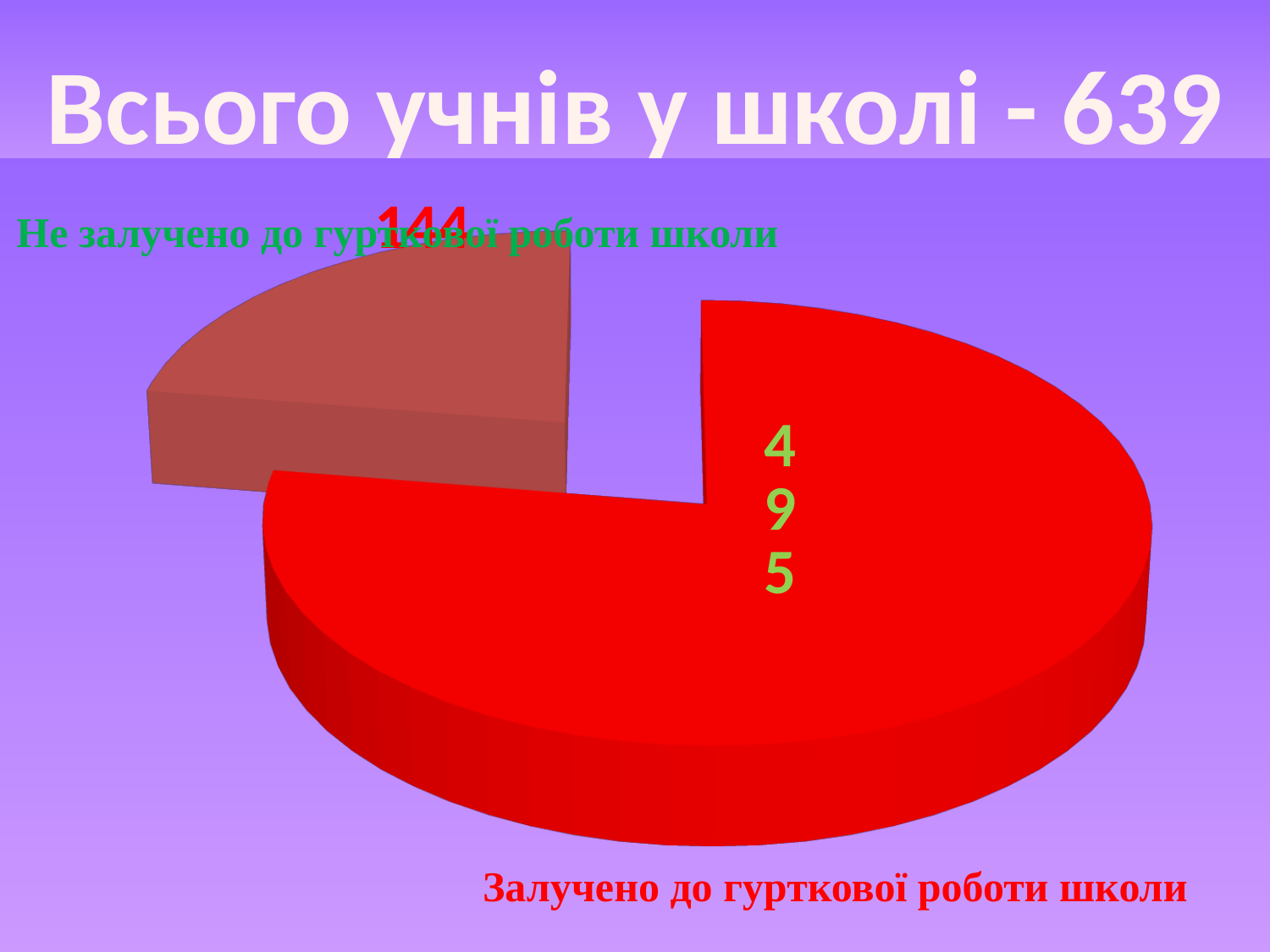
What is the value for "Не залучено до гурткової роботи школи"? 144 What is the total number of pupils represented by the two slices of the pie chart? 639 How many slices does the pie chart have? 2 What colour is the slice for "Залучено до гурткової роботи школи"? red Which slice of the pie chart is the smallest? Не залучено до гурткової роботи школи Which slice of the pie chart is the largest? Залучено до гурткової роботи школи Which is larger: the value for "Залучено до гурткової роботи школи" or for "Не залучено до гурткової роботи школи"? Залучено до гурткової роботи школи What is the title of the slide above the pie chart? Всього учнів у школі - 639 What kind of chart is shown on the slide? pie chart What is the difference between the number of pupils involved in club work (Залучено) and those not involved (Не залучено)? 351 What is the value for "Залучено до гурткової роботи школи"? 495